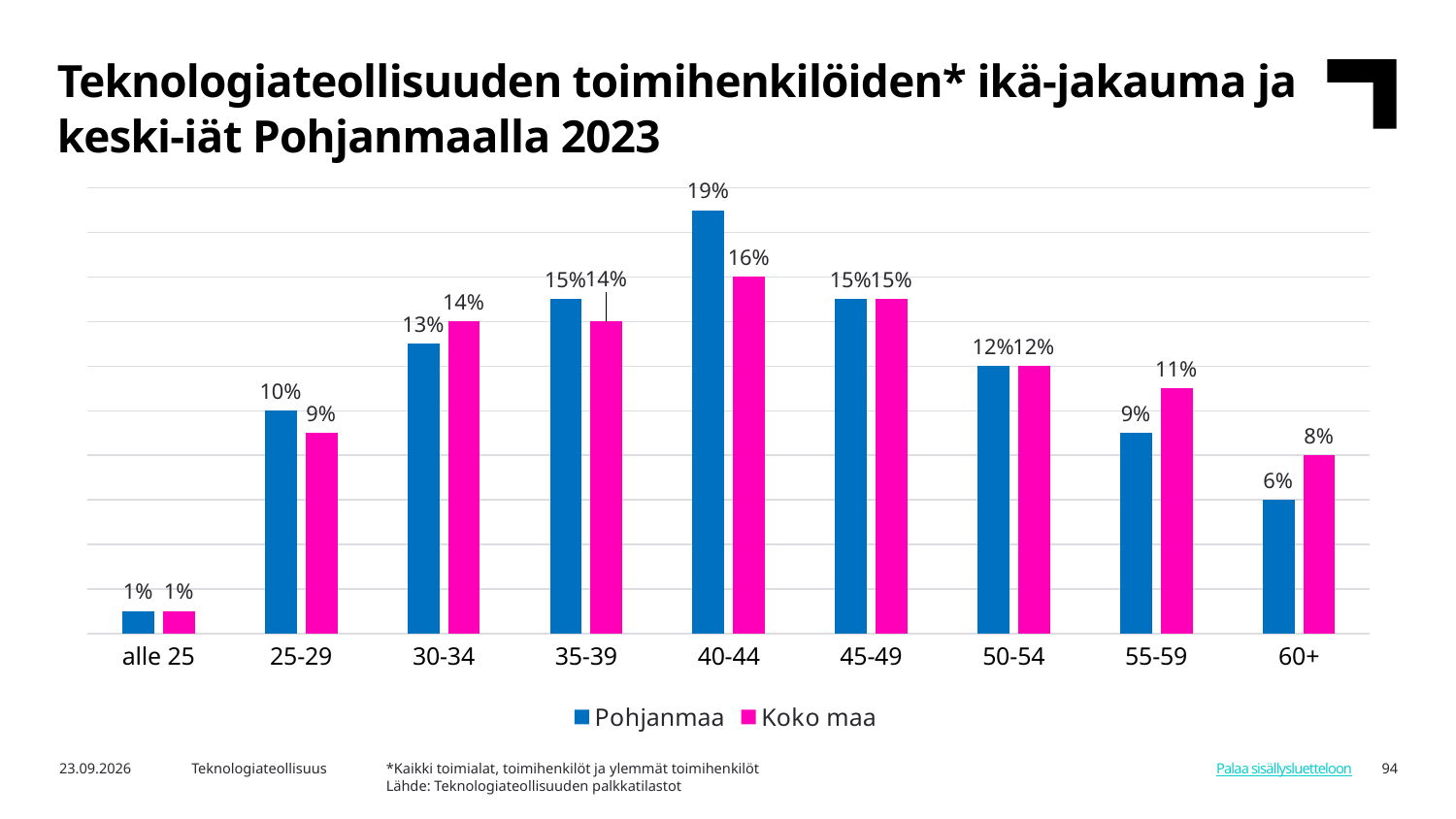
How many age groups are shown on the x axis? 9 Which series is shown in pink in the legend? Koko maa Which age group has the highest value for Pohjanmaa? 40-44 What is the difference between the Pohjanmaa and Koko maa values in the 40-44 age group? 3 percentage points What kind of chart is shown on the slide? Bar chart In the 25-29 age group, which series has the larger value, Pohjanmaa or Koko maa? Pohjanmaa What is the value for Pohjanmaa in the 40-44 age group? 19% In the 60+ age group, which series has the larger value, Pohjanmaa or Koko maa? Koko maa How many series does the legend list? 2 What is the value for Pohjanmaa in the 60+ age group? 6% Which age group has the lowest value for Koko maa? alle 25 What is the value for Koko maa in the 55-59 age group? 11%